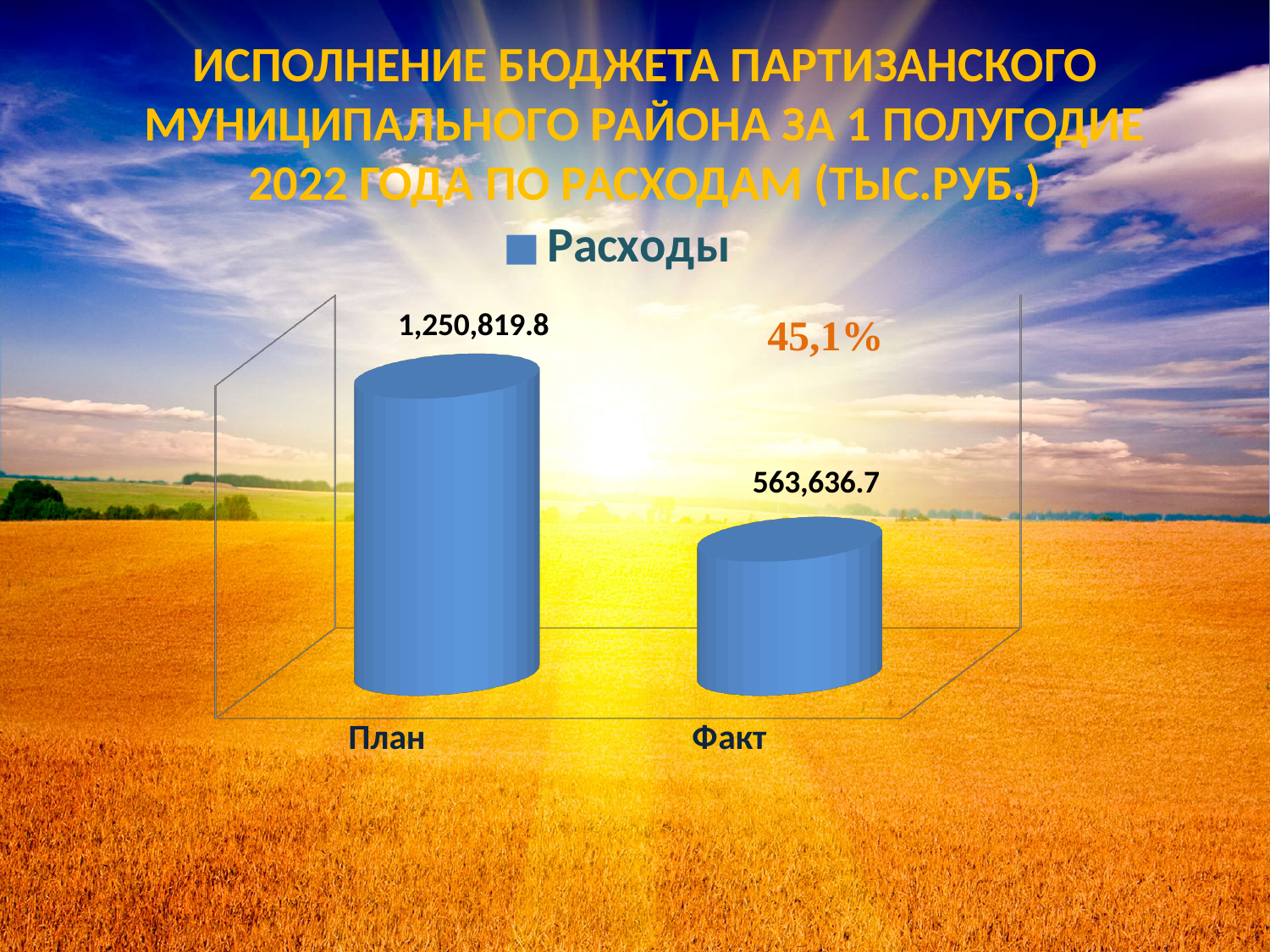
Which category has the highest value? План Do the values rise or fall from План to Факт? Fall Which is larger, the value for План or the value for Факт? План How many series does the legend list? 1 What is the difference between the values for План and Факт? 687,183.1 What percentage is printed on the chart next to the Факт bar? 45,1% What is the value for Факт? 563,636.7 What kind of chart is shown on the slide? Bar chart Which category has the lowest value? Факт What series name is shown in the chart legend? Расходы What is the value for План? 1,250,819.8 How many categories are shown on the chart? 2